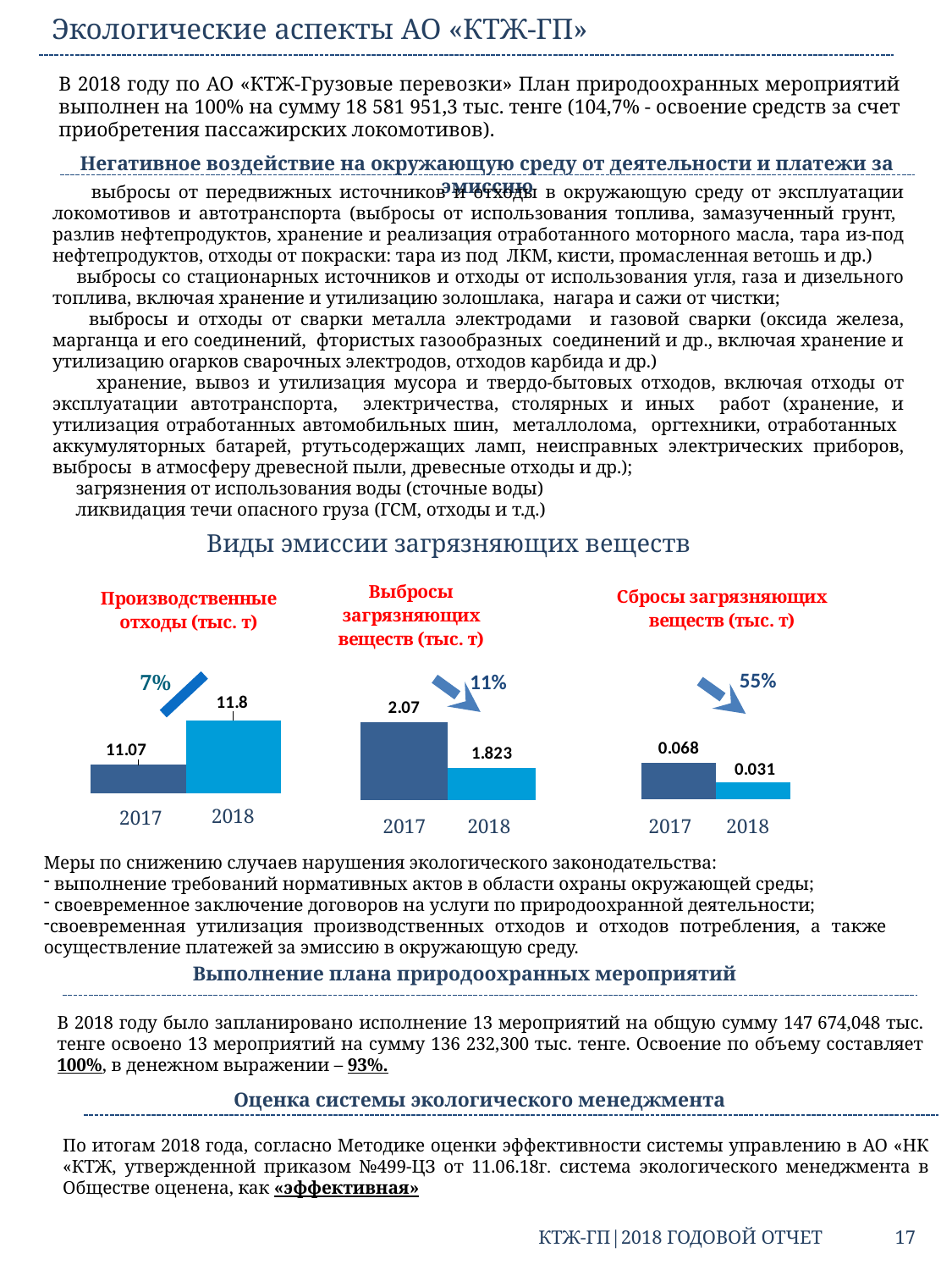
In the chart titled «Производственные отходы (тыс. т)», what is the value for 2018? 11.8 In the chart titled «Выбросы загрязняющих веществ (тыс. т)», what is the value for 2017? 2.07 In the chart titled «Сбросы загрязняющих веществ (тыс. т)», what is the difference between the 2017 and 2018 values? 0.037 In the chart titled «Сбросы загрязняющих веществ (тыс. т)», what is the value for 2017? 0.068 What percentage change is shown next to the arrow in the chart titled «Сбросы загрязняющих веществ (тыс. т)»? 55% In the chart titled «Выбросы загрязняющих веществ (тыс. т)», do the values rise or fall from 2017 to 2018? fall In the chart titled «Выбросы загрязняющих веществ (тыс. т)», what is the value for 2018? 1.823 In the chart titled «Сбросы загрязняющих веществ (тыс. т)», what is the value for 2018? 0.031 In the chart titled «Выбросы загрязняющих веществ (тыс. т)», which year has the lower value? 2018 In the chart titled «Производственные отходы (тыс. т)», which year has the higher value? 2018 What type of chart is used for «Производственные отходы (тыс. т)»? bar chart In the chart titled «Производственные отходы (тыс. т)», what is the value for 2017? 11.07